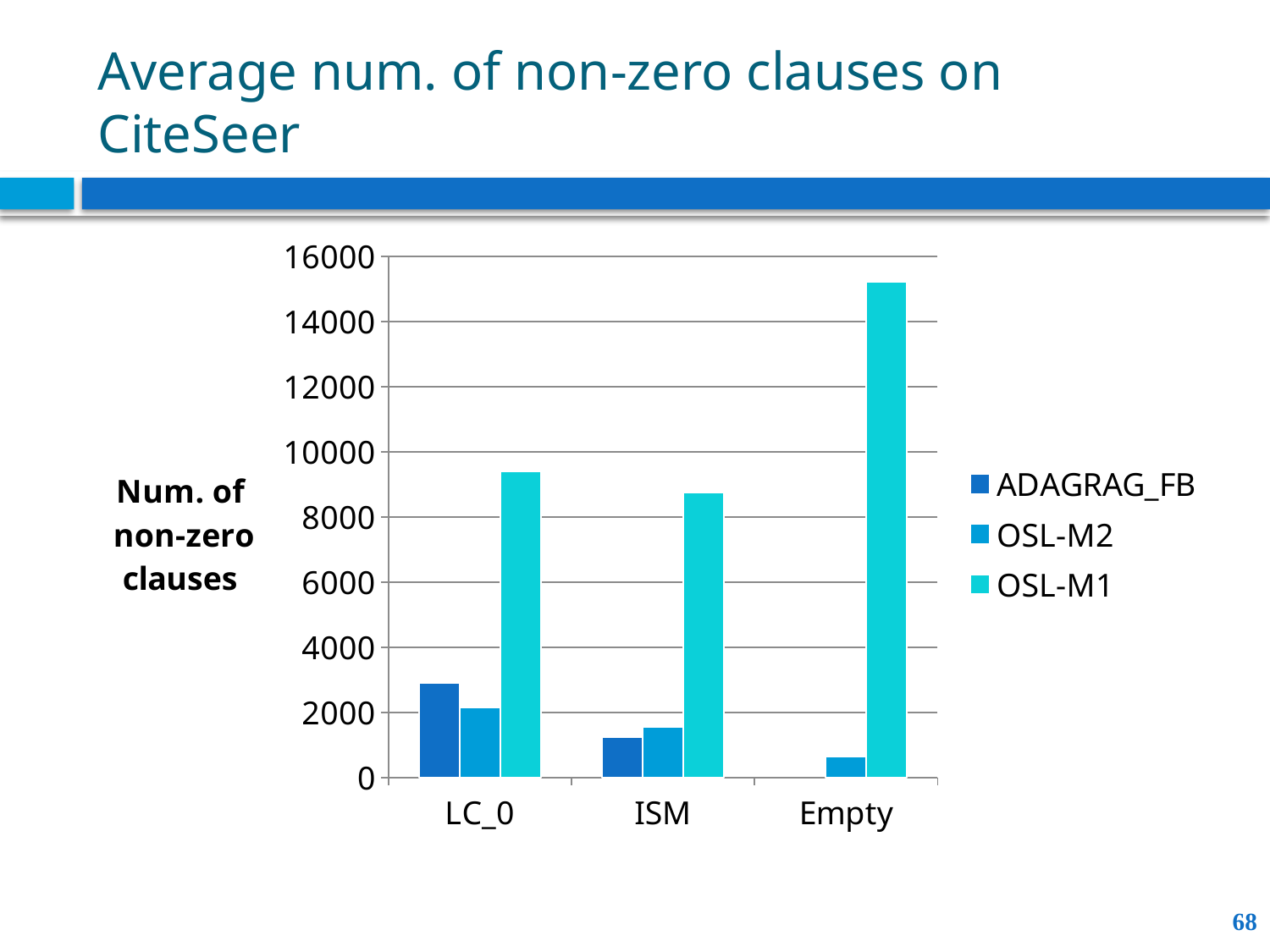
Is the ADAGRAG_FB value for LC_0 greater or less than 2000? greater For LC_0, which is larger: the ADAGRAG_FB value or the OSL-M2 value? ADAGRAG_FB What is the title of the chart? Average num. of non-zero clauses on CiteSeer Which category has the highest OSL-M1 value? Empty Is the OSL-M1 value for Empty greater or less than 14000? greater How many categories are shown on the x axis? 3 Which series has the highest value in every category? OSL-M1 What kind of chart is shown on the slide? bar chart Is the OSL-M2 value for Empty greater or less than 2000? less Which category has the lowest OSL-M1 value? ISM How many series does the legend list? 3